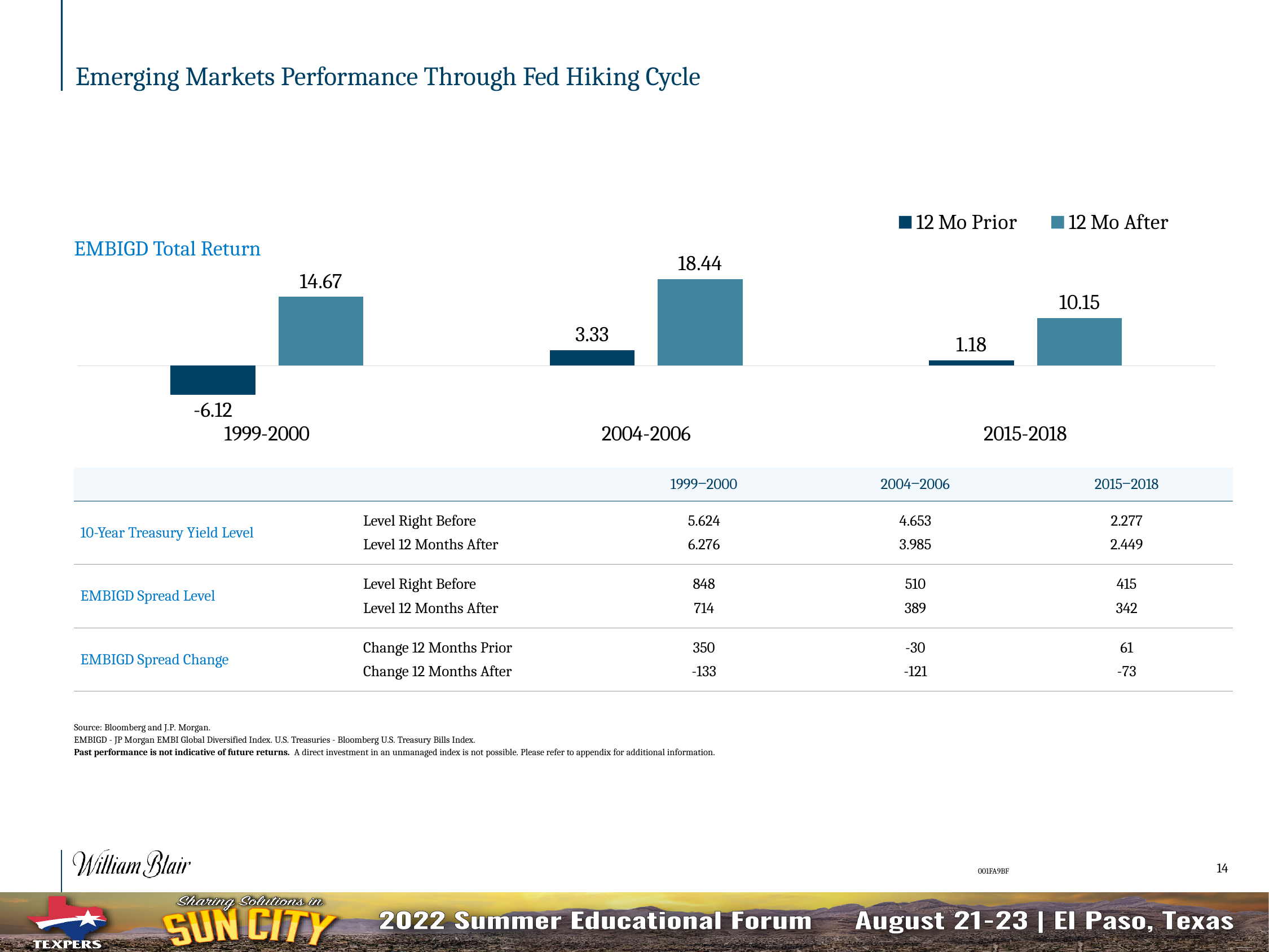
What is the difference between the 12 Mo After and 12 Mo Prior values for 2015-2018 in the EMBIGD Total Return chart? 8.97 Which period has the lowest 12 Mo Prior value in the EMBIGD Total Return chart? 1999-2000 What is the 12 Mo Prior value for 2004-2006 in the EMBIGD Total Return chart? 3.33 How many series does the legend of the EMBIGD Total Return chart list? 2 What is the 12 Mo After value for 2004-2006 in the EMBIGD Total Return chart? 18.44 In the EMBIGD Total Return chart, which is larger for 1999-2000: the 12 Mo Prior value or the 12 Mo After value? 12 Mo After What is the 12 Mo After value for 2015-2018 in the EMBIGD Total Return chart? 10.15 What are the two series named in the legend of the EMBIGD Total Return chart? 12 Mo Prior and 12 Mo After How many periods are shown on the x axis of the EMBIGD Total Return chart? 3 What kind of chart is the EMBIGD Total Return chart? Bar chart What is the 12 Mo Prior value for 1999-2000 in the EMBIGD Total Return chart? -6.12 Which period has the highest 12 Mo After value in the EMBIGD Total Return chart? 2004-2006